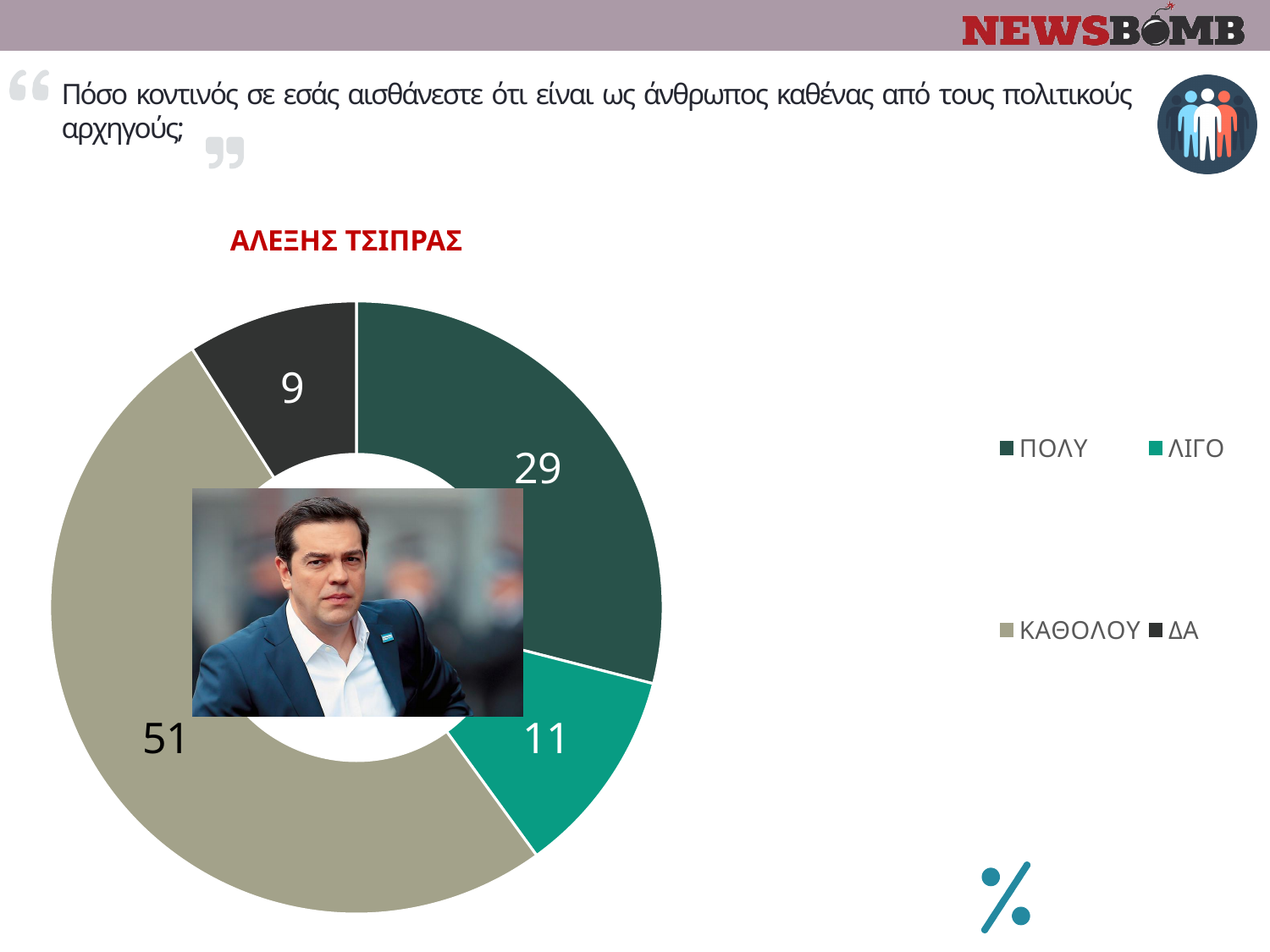
Which category has the largest slice in the chart? ΚΑΘΟΛΟΥ What is the difference between the values for ΚΑΘΟΛΟΥ and ΠΟΛΥ? 22 What kind of chart is shown on the slide? Doughnut chart How many slices does the chart have? 4 What value is shown for ΚΑΘΟΛΟΥ in the chart? 51 How many entries does the legend list? 4 Which is larger, the value for ΠΟΛΥ or the value for ΛΙΓΟ? ΠΟΛΥ What value is shown for ΛΙΓΟ in the chart? 11 What value is shown for ΔΑ in the chart? 9 Which category has the smallest slice in the chart? ΔΑ What value is shown for ΠΟΛΥ in the chart? 29 What is the title of the chart? ΑΛΕΞΗΣ ΤΣΙΠΡΑΣ